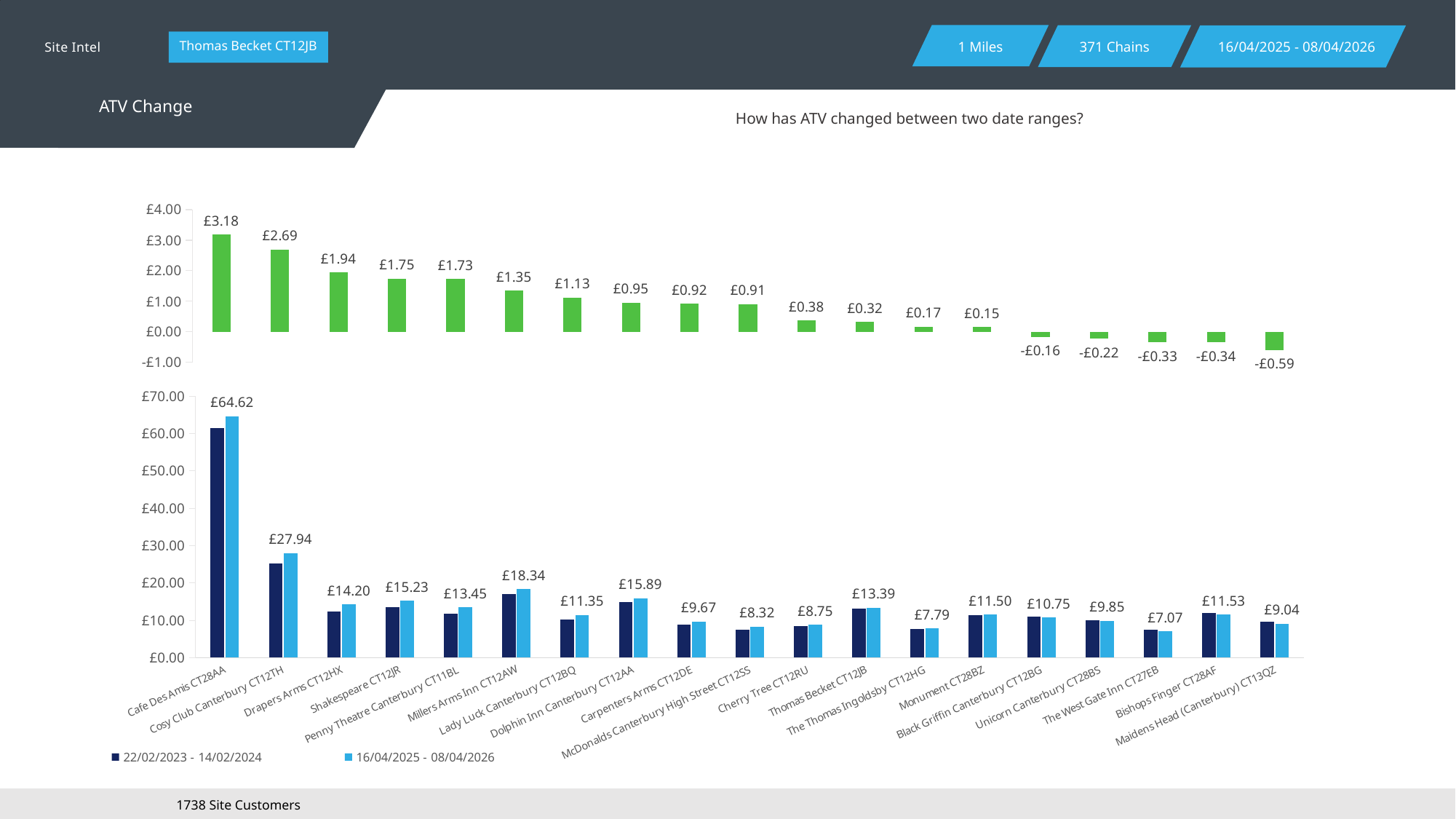
How many series does the legend of the bottom chart list? 2 What kind of chart is the bottom chart? bar chart On the bottom chart, which category has the lowest value in the 16/04/2025 - 08/04/2026 series? The West Gate Inn CT27EB On the bottom chart, what is the value for Millers Arms Inn CT12AW in the 16/04/2025 - 08/04/2026 series? £18.34 On the bottom chart, which is larger in the 16/04/2025 - 08/04/2026 series: Dolphin Inn Canterbury CT12AA or Lady Luck Canterbury CT12BQ? Dolphin Inn Canterbury CT12AA On the bottom chart, is the value for Cafe Des Amis CT28AA in the 22/02/2023 - 14/02/2024 series greater or less than £50.00? greater On the bottom chart, what is the value for Cafe Des Amis CT28AA in the 16/04/2025 - 08/04/2026 series? £64.62 On the bottom chart, which category has the highest value in the 16/04/2025 - 08/04/2026 series? Cafe Des Amis CT28AA On the bottom chart, what is the difference between Cosy Club Canterbury CT12TH and Drapers Arms CT12HX in the 16/04/2025 - 08/04/2026 series? £13.74 On the top chart, what is the highest value shown? £3.18 On the top chart, what is the lowest value shown? -£0.59 How many categories are shown on the bottom chart? 19